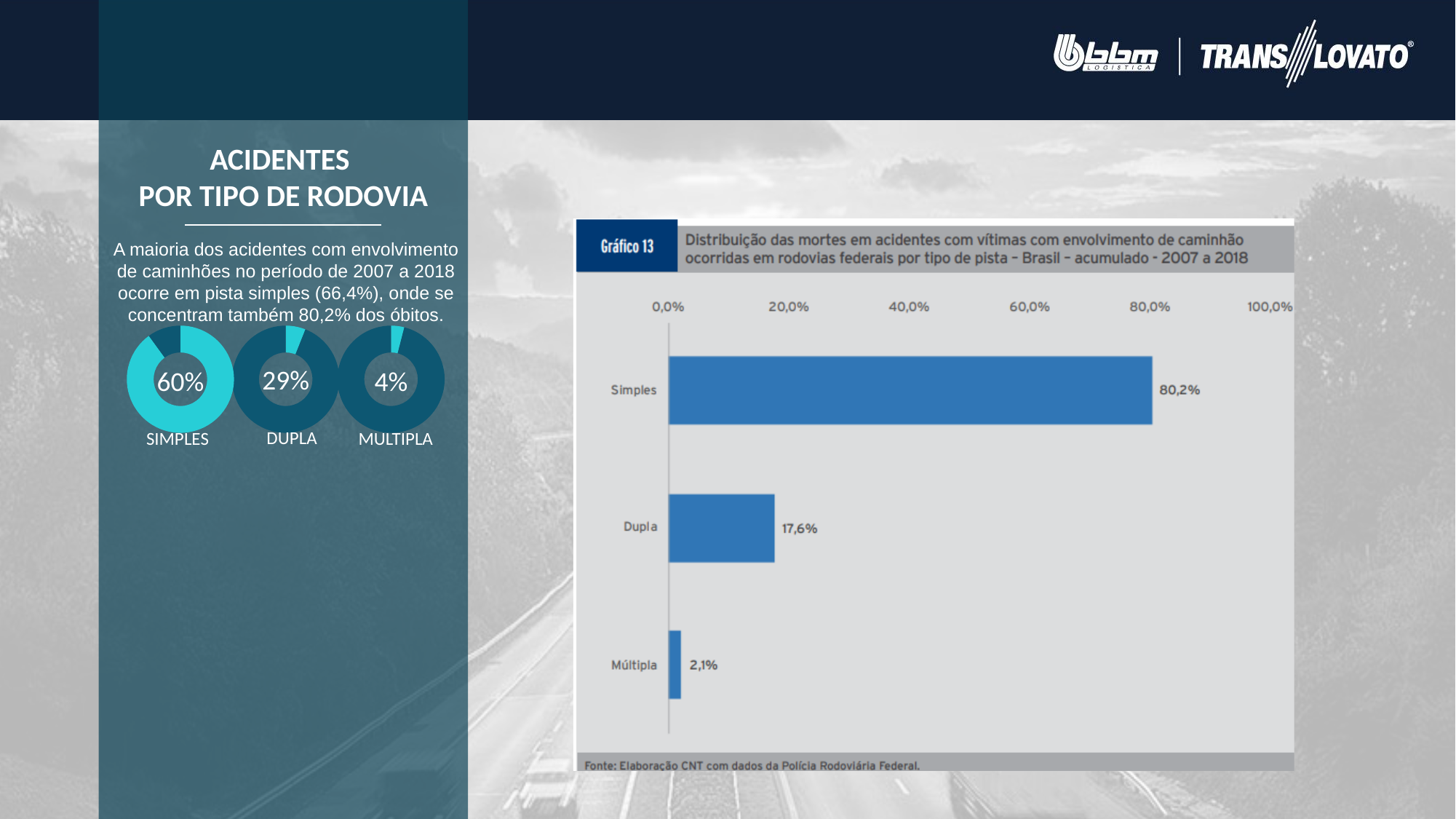
In the Gráfico 13 bar chart, what is the difference between the values for Simples and Dupla? 62,6% In the Gráfico 13 bar chart, what is the value for Simples? 80,2% How many categories are shown in the Gráfico 13 bar chart? 3 In the donut charts on the left of the slide, what percentage is shown for DUPLA? 29% In the Gráfico 13 bar chart, what is the value for Múltipla? 2,1% In the Gráfico 13 bar chart, what is the value for Dupla? 17,6% In the Gráfico 13 bar chart, which category has the highest value? Simples In the Gráfico 13 bar chart, which category has the lowest value? Múltipla In the Gráfico 13 bar chart, is the value for Dupla greater or less than 20,0%? less In the donut charts on the left of the slide, what percentage is shown for SIMPLES? 60% What kind of chart is Gráfico 13 on the right of the slide? bar chart What is the source cited below the Gráfico 13 bar chart? Elaboração CNT com dados da Polícia Rodoviária Federal